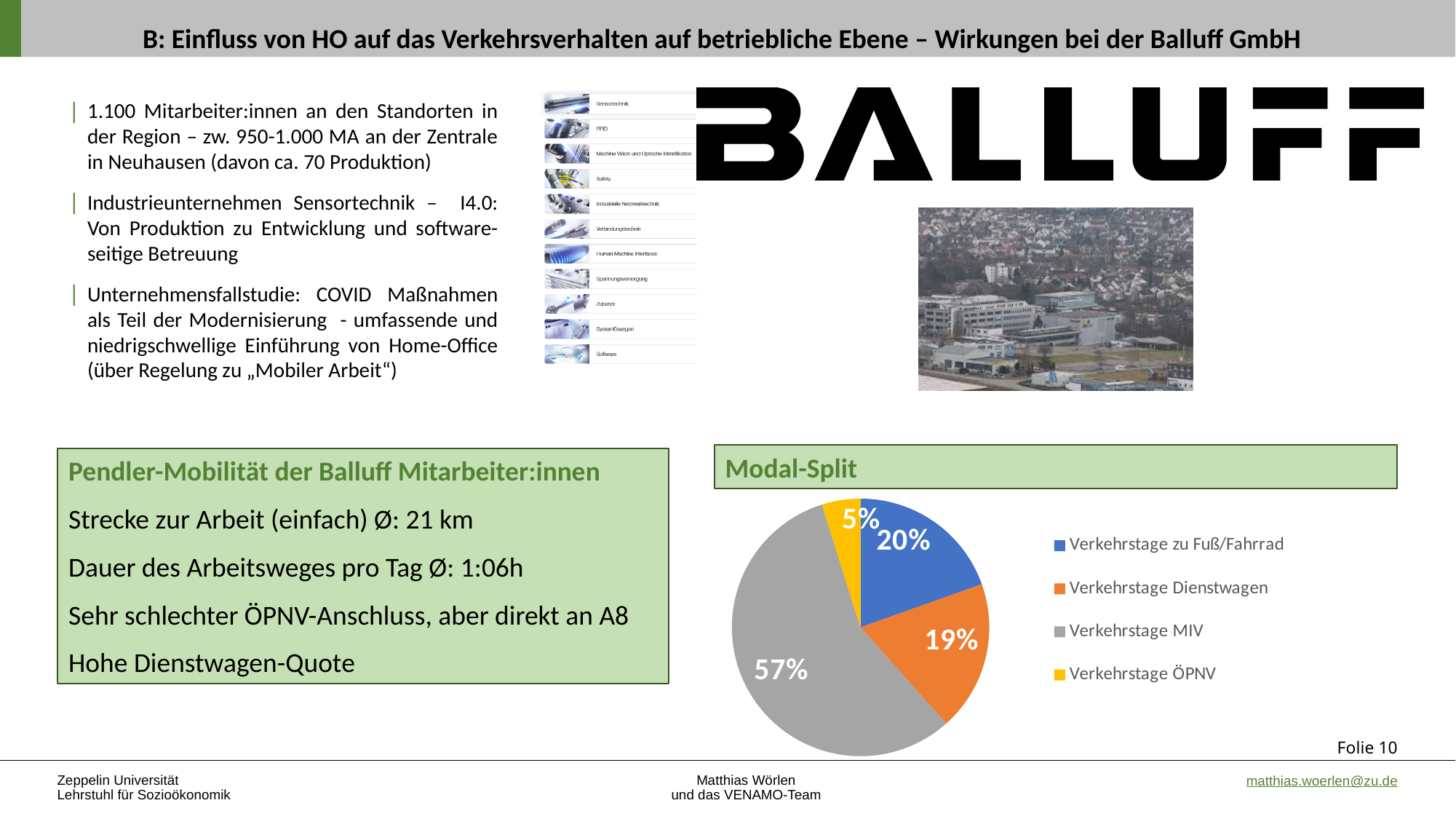
What kind of chart is shown under the heading "Modal-Split"? pie chart How many categories does the legend of the Modal-Split pie chart list? 4 Which category has the largest slice in the Modal-Split pie chart? Verkehrstage MIV In the Modal-Split pie chart, which colour represents Verkehrstage ÖPNV? yellow In the Modal-Split pie chart, what is the difference between the shares for Verkehrstage MIV and Verkehrstage ÖPNV? 52% In the Modal-Split pie chart, what share is labelled for Verkehrstage Dienstwagen? 19% In the Modal-Split pie chart, what share is labelled for Verkehrstage zu Fuß/Fahrrad? 20% Which category has the smallest slice in the Modal-Split pie chart? Verkehrstage ÖPNV In the Modal-Split pie chart, which colour represents Verkehrstage MIV? grey In the Modal-Split pie chart, what share is labelled for Verkehrstage ÖPNV? 5% In the Modal-Split pie chart, what is the difference between the shares for Verkehrstage zu Fuß/Fahrrad and Verkehrstage Dienstwagen? 1% In the Modal-Split pie chart, what share is labelled for Verkehrstage MIV? 57%